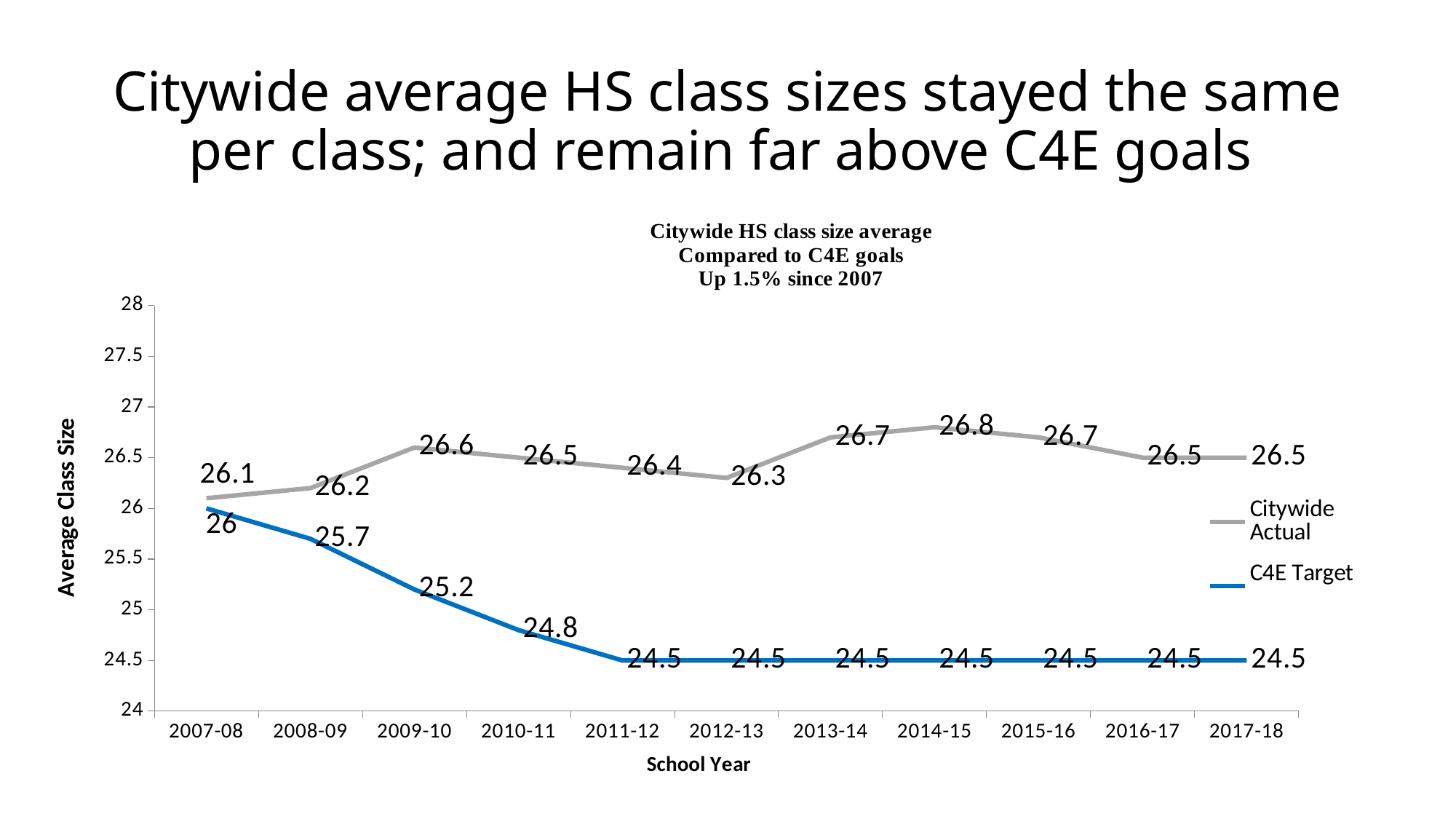
What colour is the C4E Target line? Blue In which school year was the Citywide Actual class size highest? 2014-15 Does the C4E Target line rise or fall from 2007-08 to 2011-12? Fall Which is larger in 2012-13: the Citywide Actual value or the C4E Target value? Citywide Actual What is the difference between the Citywide Actual and C4E Target values in 2017-18? 2 In which school year was the Citywide Actual class size lowest? 2007-08 What was the Citywide Actual average class size in 2007-08? 26.1 What was the Citywide Actual average HS class size in 2014-15? 26.8 What was the C4E Target class size in 2009-10? 25.2 How many series does the legend list? 2 How many school years are shown on the x axis? 11 What kind of chart is shown on the slide? Line chart